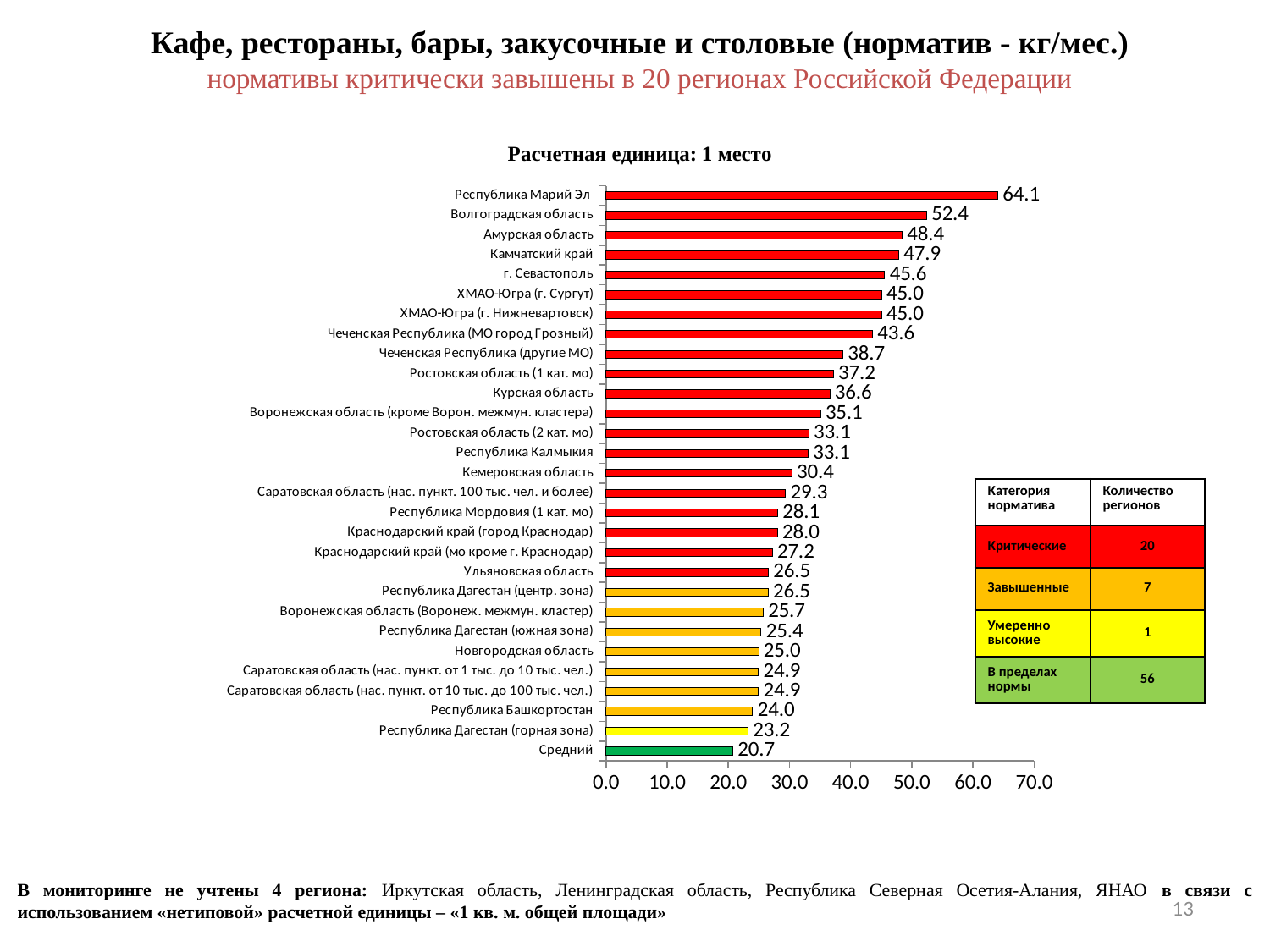
What is the value for Средний? 20.7 What is the value for Новгородская область? 25.0 What is the value for Республика Марий Эл? 64.1 Is the value for Кемеровская область greater or less than 40.0? less How many categories are shown on the chart? 29 What is the difference between the values for Республика Марий Эл and Волгоградская область? 11.7 Which is larger, the value for Амурская область or the value for Камчатский край? Амурская область Which category has the lowest value? Средний What is the value for Курская область? 36.6 What kind of chart is shown on the slide? bar chart Which category has the highest value? Республика Марий Эл What is the title of the chart? Расчетная единица: 1 место